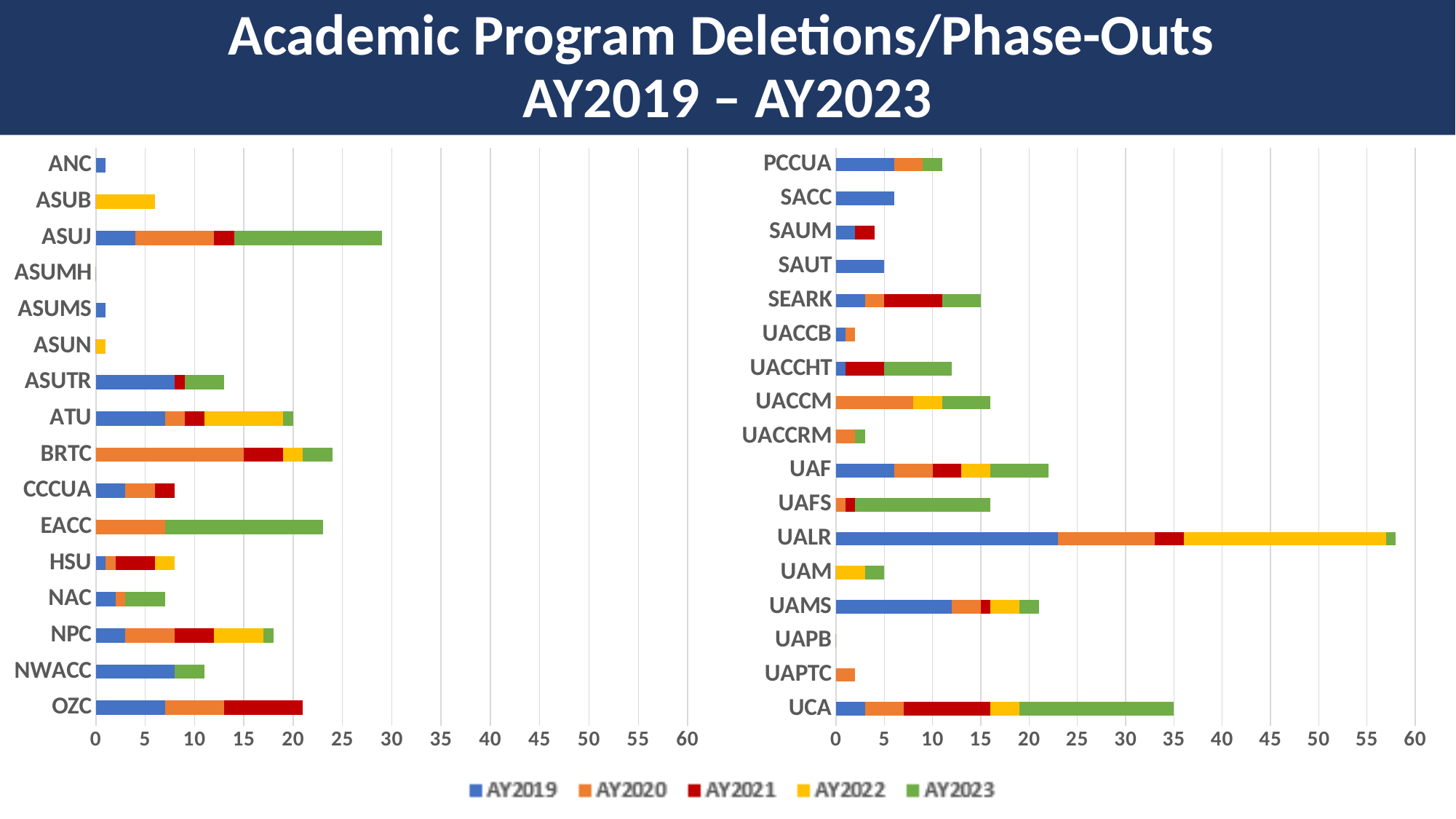
How many series does the legend list? 5 How many institutions are listed on the right chart? 17 On the left chart, which institution has the longest total bar? ASUJ On the left chart, is the total bar for ASUJ greater or less than 25? greater On the right chart, is the total bar for UCA greater or less than 30? greater On the right chart, is the total bar for SACC greater or less than 10? less How many institutions are listed on the left chart? 16 What kind of chart is shown on the left side of the slide? Stacked bar chart On the right chart, which institution has the longest total bar? UALR Which series in the legend is shown in green? AY2023 On the right chart, which has the longer total bar, UCA or UAF? UCA